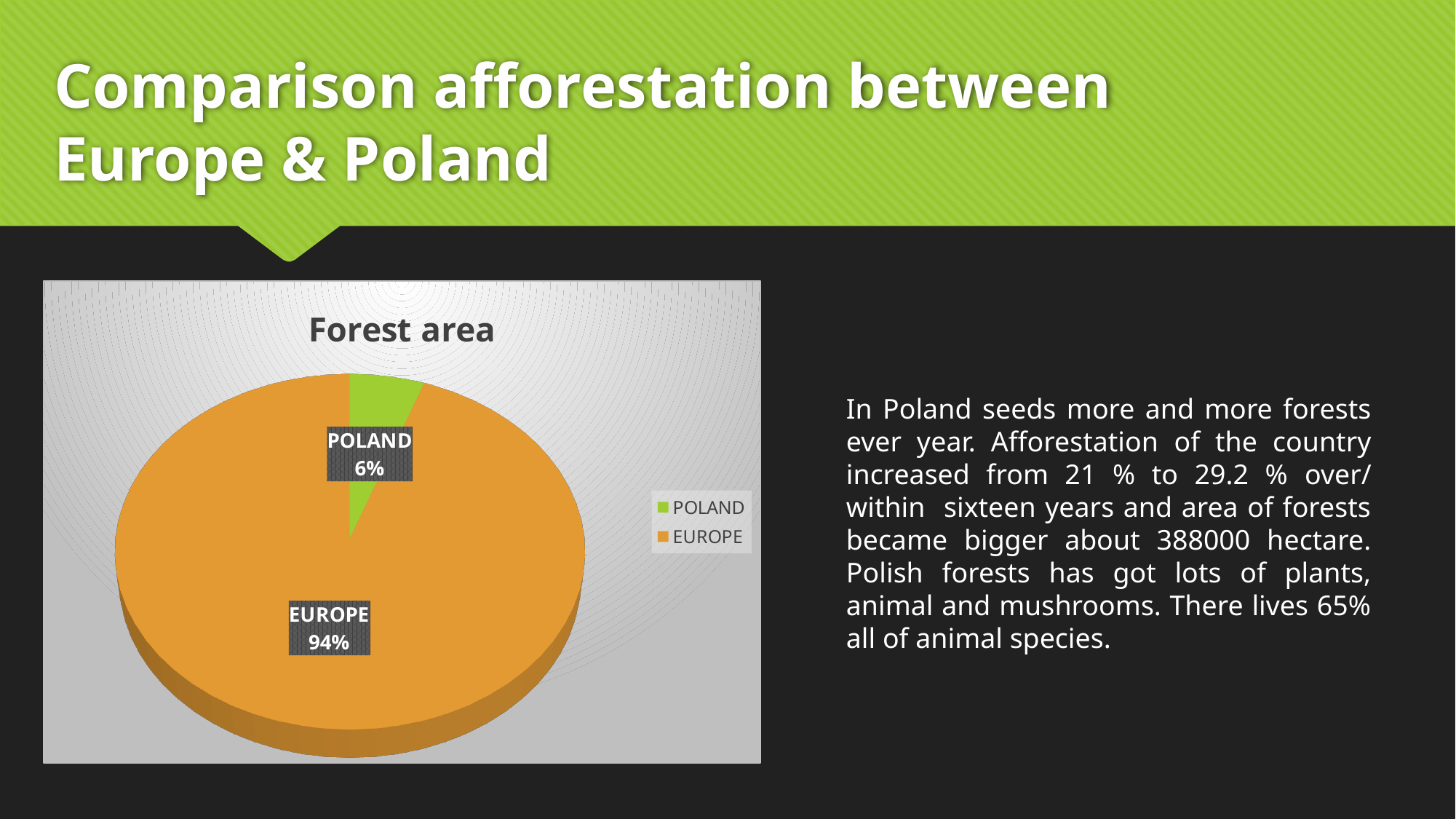
What is the title of the chart? Forest area What colour is the POLAND slice? green What share of the pie does EUROPE have? 94% What is the difference in percentage points between the EUROPE and POLAND slices? 88 Which is larger, the POLAND slice or the EUROPE slice? EUROPE How many slices does the pie chart have? 2 Which slice of the pie is the largest? EUROPE What share of the pie does POLAND have? 6% Which slice of the pie is the smallest? POLAND How many entries does the legend list? 2 What kind of chart is shown on the slide? pie chart